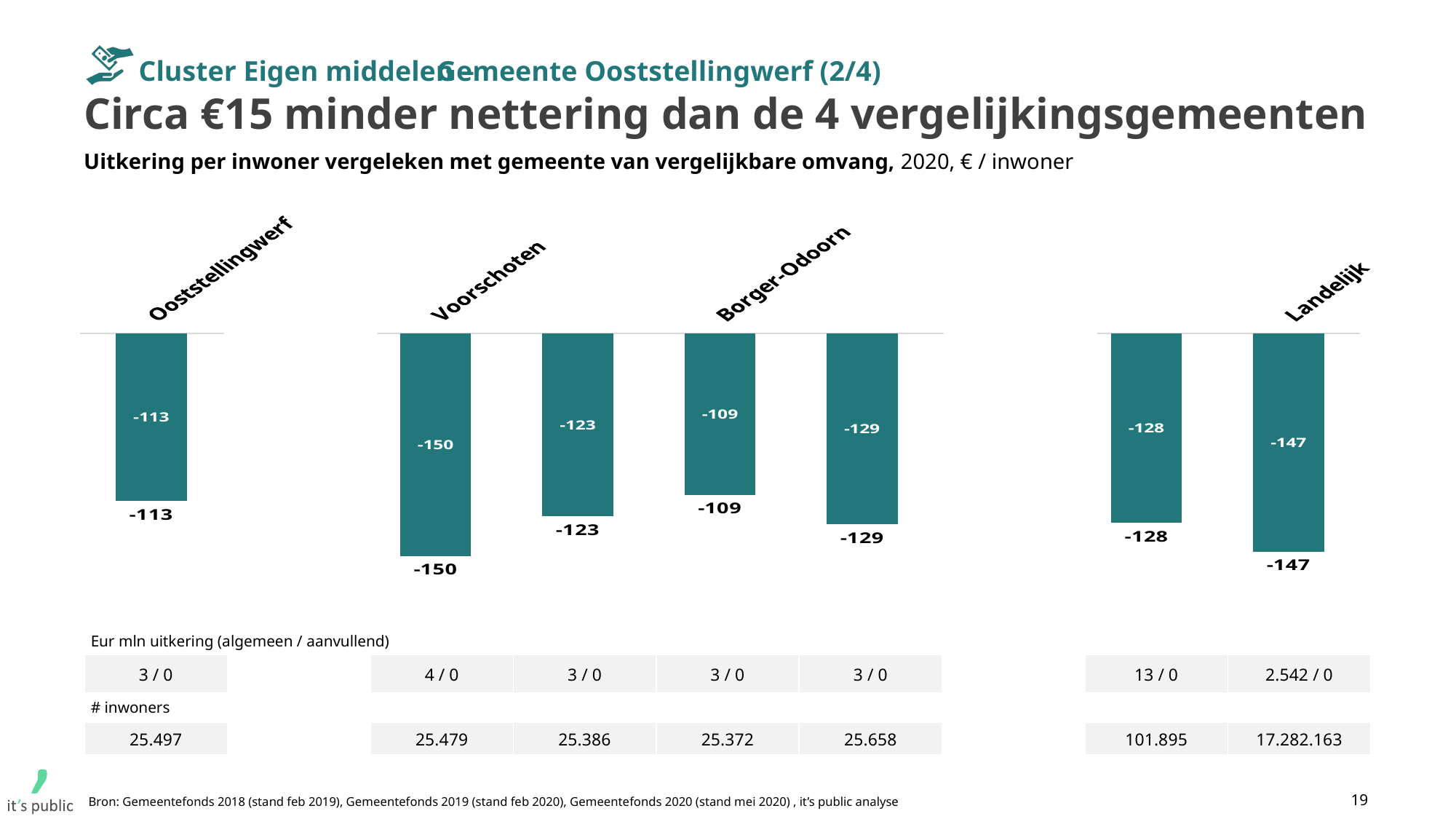
Which labelled bar has the highest (least negative) value? Borger-Odoorn What is the difference between the values for Ooststellingwerf and Landelijk? 34 How many bars are plotted in the chart? 7 What is the value shown for Landelijk? -147 Which labelled bar has the most negative (lowest) value? Voorschoten What is the value shown for Voorschoten? -150 In what unit are the chart values expressed, according to the subtitle? € / inwoner What is the difference between the values for Voorschoten and Ooststellingwerf? 37 Which has the longer (more negative) bar, Ooststellingwerf or Landelijk? Landelijk What kind of chart is shown on the slide? Bar chart What is the value shown for Ooststellingwerf? -113 What is the value shown for Borger-Odoorn? -109